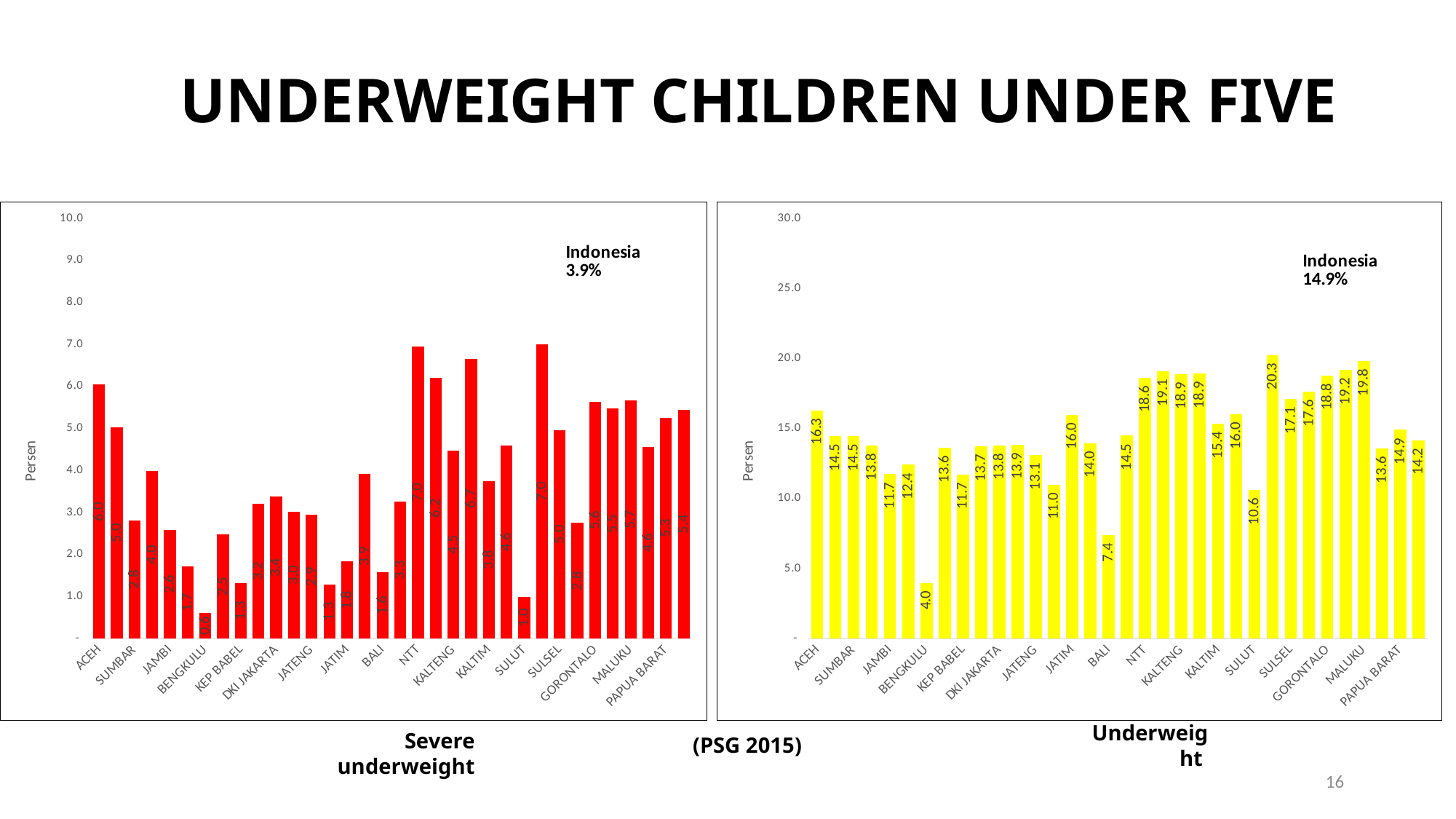
On the Underweight chart, what is the national value given for Indonesia? 14.9% On the Severe underweight chart, what is the value for ACEH? 6.0 On the Underweight chart, is the value for BALI greater or less than 10.0? less On the Underweight chart, what is the value for ACEH? 16.3 What source is cited below the charts? PSG 2015 On the Severe underweight chart, what is the lowest value shown on any bar? 0.6 On the Underweight chart, what is the lowest value shown on any bar? 4.0 On the Severe underweight chart, what is the national value given for Indonesia? 3.9% On the Underweight chart, what is the highest value shown on any bar? 20.3 What kind of chart is the Severe underweight chart on the left? Bar chart On the Underweight chart, which is larger, the value for ACEH or the value for BENGKULU? ACEH What colour are the bars on the Underweight chart on the right? Yellow